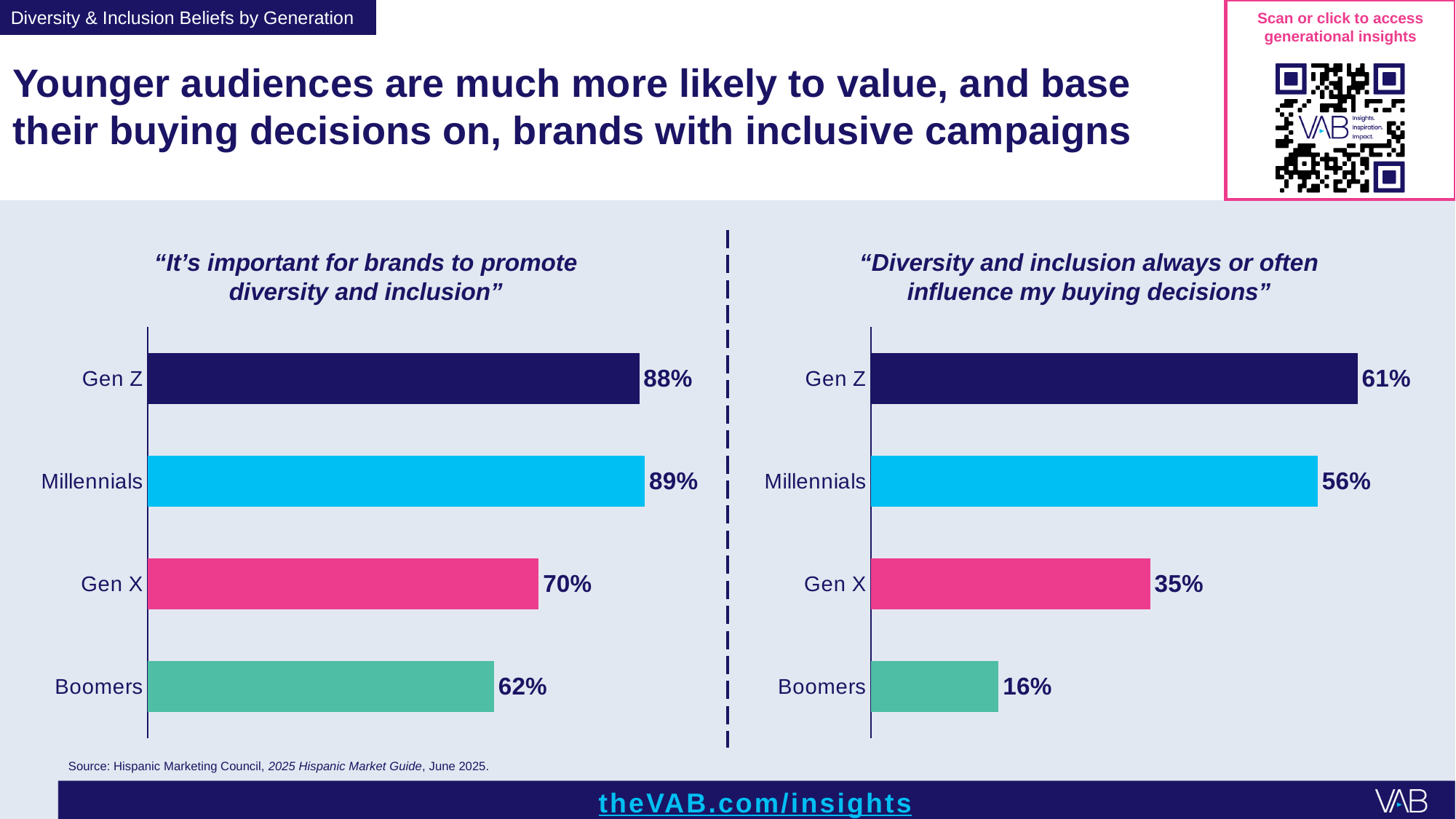
How many generations are shown in the right chart ("Diversity and inclusion always or often influence my buying decisions")? 4 In the right chart ("Diversity and inclusion always or often influence my buying decisions"), what is the value for Boomers? 16% In the right chart ("Diversity and inclusion always or often influence my buying decisions"), what colour is the Gen X bar? Pink In the right chart ("Diversity and inclusion always or often influence my buying decisions"), which generation has the highest value? Gen Z In the right chart ("Diversity and inclusion always or often influence my buying decisions"), which generation has the lowest value? Boomers In the right chart ("Diversity and inclusion always or often influence my buying decisions"), what is the value for Millennials? 56% In the left chart ("It's important for brands to promote diversity and inclusion"), what is the difference between the Gen X and Boomers values? 8% In the right chart ("Diversity and inclusion always or often influence my buying decisions"), what is the difference between the Gen Z and Boomers values? 45% In the left chart ("It's important for brands to promote diversity and inclusion"), which is larger, the value for Gen X or the value for Boomers? Gen X In the left chart ("It's important for brands to promote diversity and inclusion"), what is the value for Gen Z? 88% In the left chart ("It's important for brands to promote diversity and inclusion"), which generation has the highest value? Millennials What kind of chart is the left chart ("It's important for brands to promote diversity and inclusion")? Bar chart